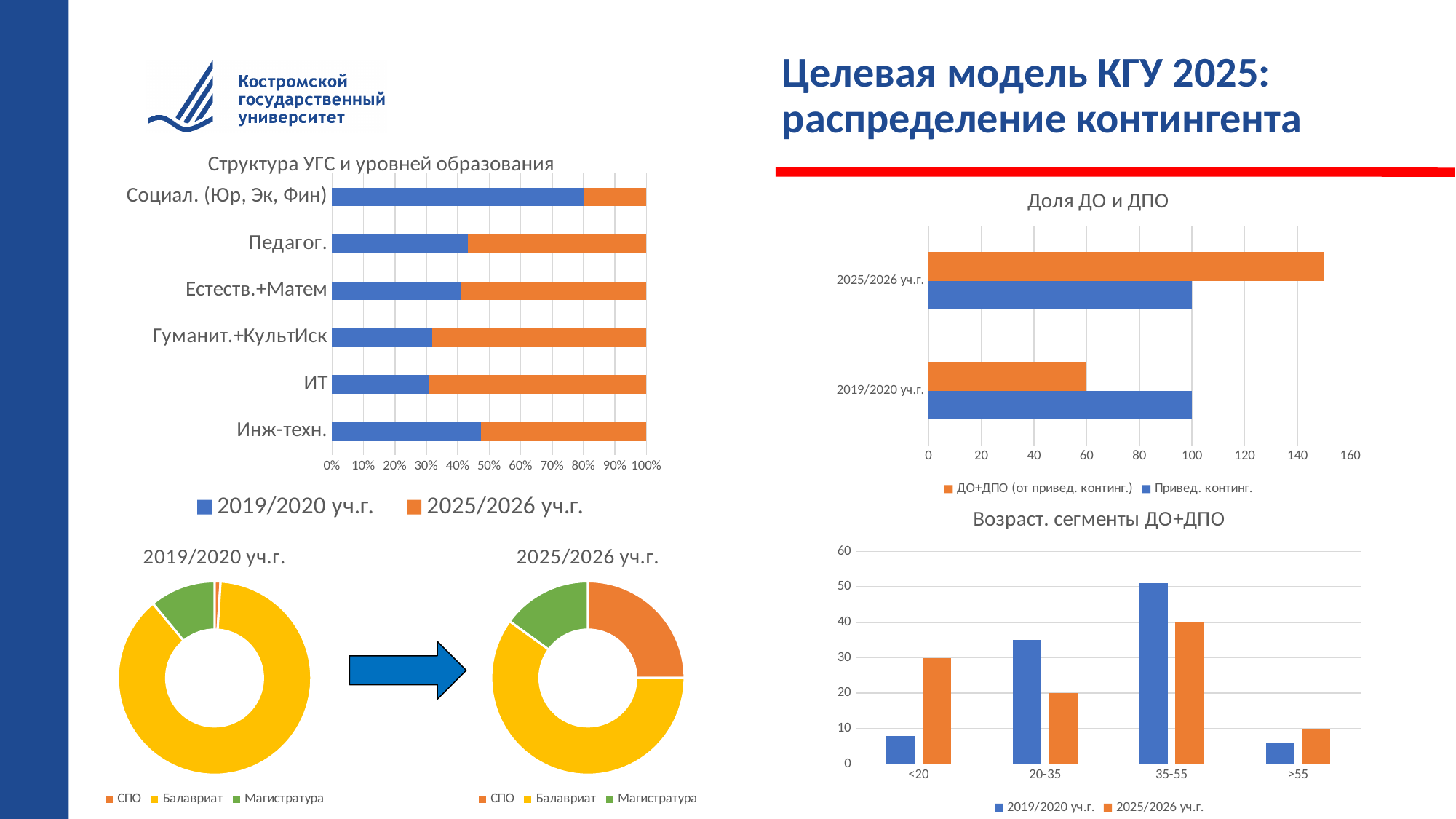
In the chart titled "Структура УГС и уровней образования", how many categories are listed on the vertical axis? 6 In the chart titled "Возраст. сегменты ДО+ДПО", which age segment has the lowest value for 2019/2020 уч.г.? >55 In the chart titled "Возраст. сегменты ДО+ДПО", what is the value for 2025/2026 уч.г. in the "35-55" segment? 40 In the chart titled "Возраст. сегменты ДО+ДПО", is the 2019/2020 уч.г. value for "20-35" greater or less than 30? greater In the chart titled "Доля ДО и ДПО", what is the value of "ДО+ДПО (от привед. континг.)" for 2019/2020 уч.г.? 60 In the chart titled "Возраст. сегменты ДО+ДПО", how many age segments are shown on the x axis? 4 In the chart titled "Доля ДО и ДПО", is the value of "ДО+ДПО (от привед. континг.)" for 2025/2026 уч.г. greater or less than 140? greater In the chart titled "Доля ДО и ДПО", what is the value of "Привед. континг." for 2019/2020 уч.г.? 100 In the donut chart titled "2025/2026 уч.г.", how many series does the legend list? 3 In the chart titled "Структура УГС и уровней образования", which category has the largest share for 2019/2020 уч.г.? Социал. (Юр, Эк, Фин) In the chart titled "Возраст. сегменты ДО+ДПО", what is the value for 2025/2026 уч.г. in the "<20" segment? 30 In the chart titled "Возраст. сегменты ДО+ДПО", which age segment has the highest value for 2019/2020 уч.г.? 35-55